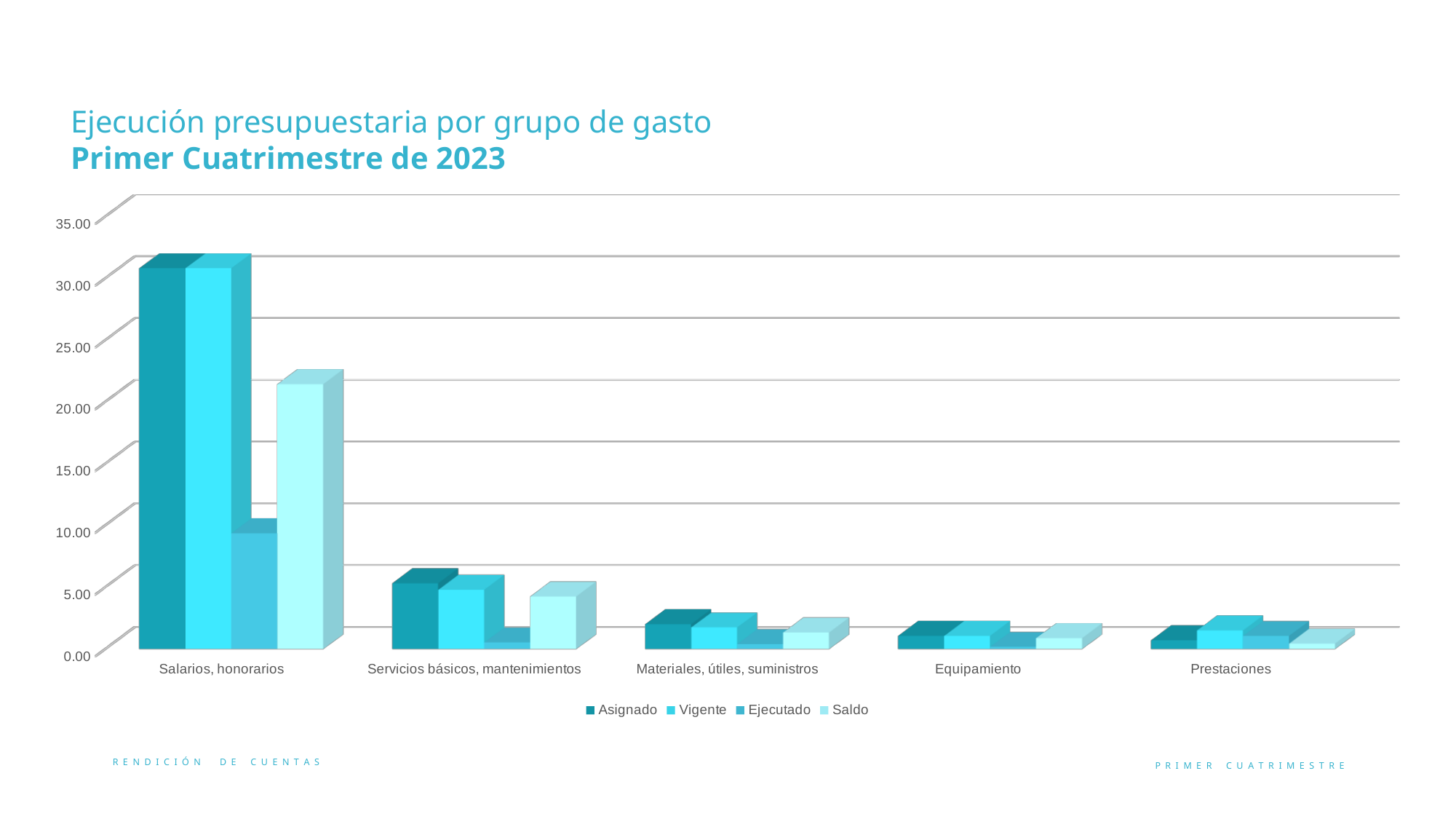
Which category has the highest Asignado value? Salarios, honorarios Is the Ejecutado value for Salarios, honorarios greater or less than 15.00? less How many categories are shown on the x axis of the chart? 5 Which is larger for Salarios, honorarios: the Ejecutado value or the Saldo value? Saldo Which is larger: the Asignado value for Salarios, honorarios or the Asignado value for Servicios básicos, mantenimientos? Salarios, honorarios Is the Asignado value for Servicios básicos, mantenimientos greater or less than 10.00? less What kind of chart is shown on the slide? bar chart What is the title of the chart? Ejecución presupuestaria por grupo de gasto Primer Cuatrimestre de 2023 How many series does the legend list? 4 Is the Asignado value for Salarios, honorarios greater or less than 25.00? greater